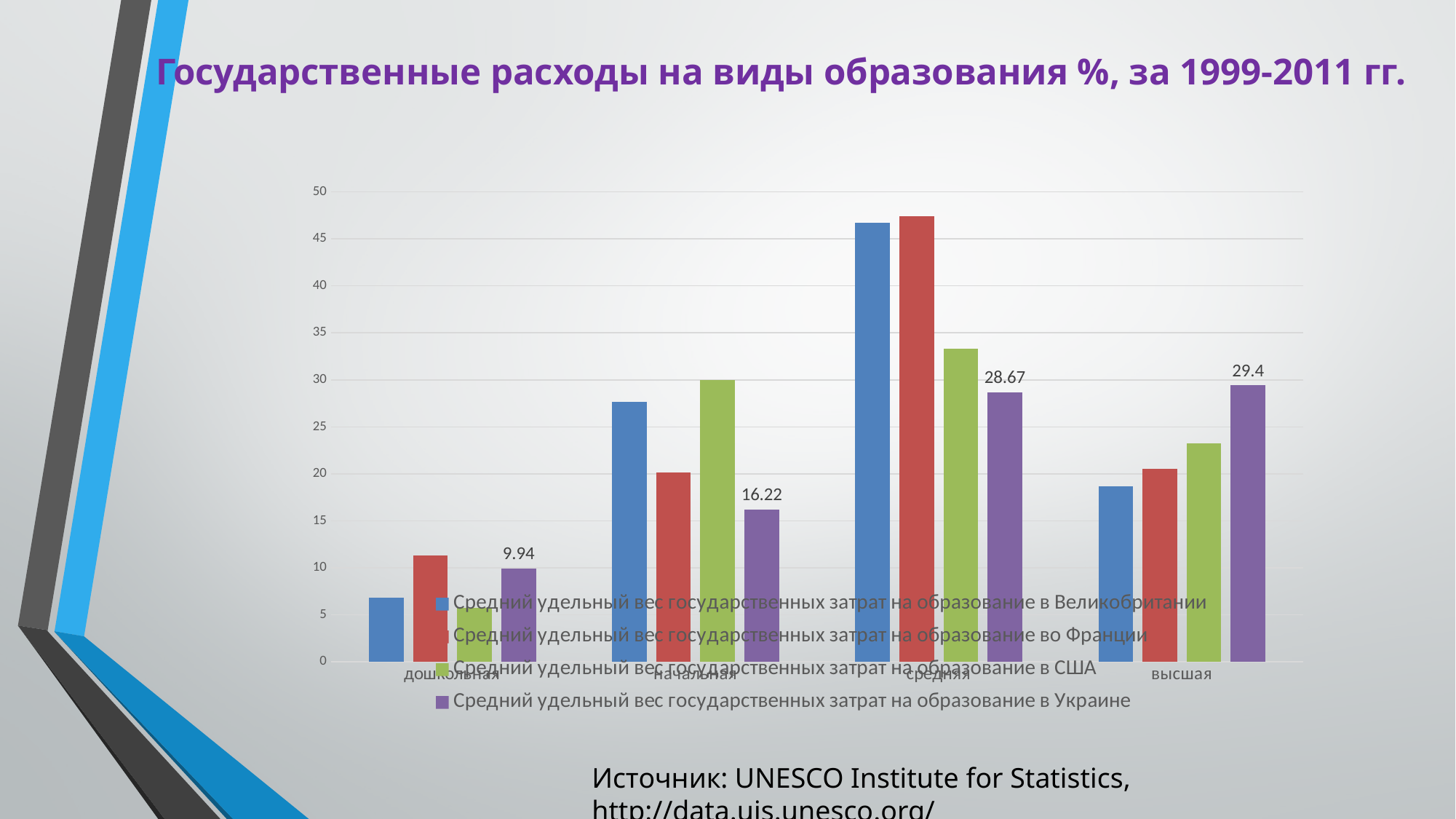
Is the value for Great Britain (Великобритания) in the средняя category greater or less than 45? greater Which is larger for Ukraine: the value for средняя or the value for высшая? высшая What is the value for Ukraine for the средняя category? 28.67 Do the Ukraine values rise or fall from дошкольная to высшая along the x axis? rise How many education categories are shown on the x axis? 4 For the Ukraine series, which category has the lowest value? дошкольная What is the difference between the Ukraine values for начальная and дошкольная? 6.28 What is the value for Ukraine for the начальная category? 16.22 What is the value for Ukraine (Средний удельный вес государственных затрат на образование в Украине) for the дошкольная category? 9.94 How many series does the legend list? 4 What is the value for Ukraine for the высшая category? 29.4 Is the value for the USA (США) in the высшая category greater or less than 20? greater